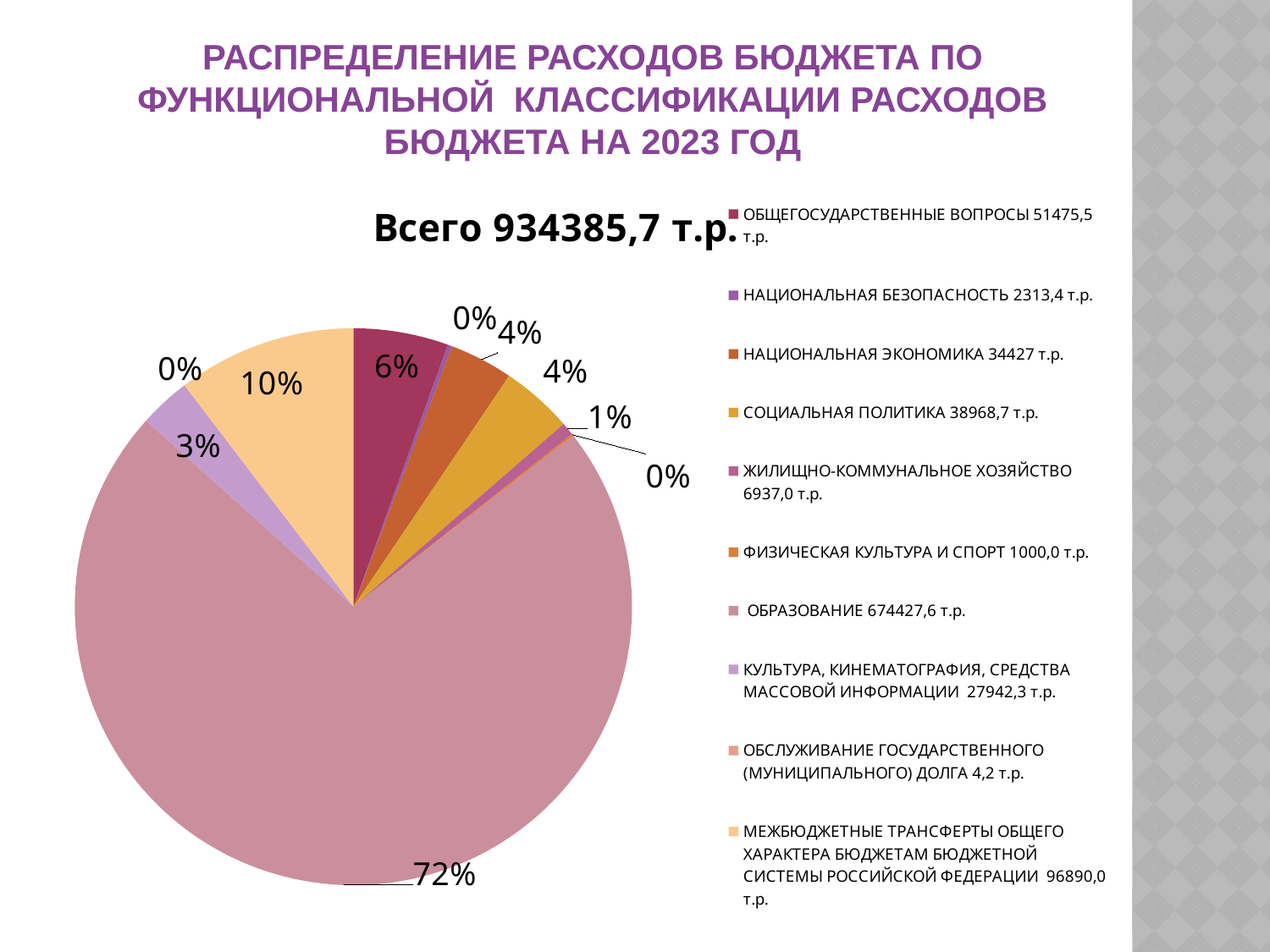
What share of the pie does ОБРАЗОВАНИЕ take? 72% What is the total of all expenditures shown in the chart title? 934385,7 т.р. What share of the pie does ОБЩЕГОСУДАРСТВЕННЫЕ ВОПРОСЫ take? 6% What value does the legend give for ОБРАЗОВАНИЕ? 674427,6 т.р. Which category has the smallest value according to the legend? ОБСЛУЖИВАНИЕ ГОСУДАРСТВЕННОГО (МУНИЦИПАЛЬНОГО) ДОЛГА By how many percentage points does the share of ОБРАЗОВАНИЕ exceed the share of МЕЖБЮДЖЕТНЫЕ ТРАНСФЕРТЫ ОБЩЕГО ХАРАКТЕРА? 62% What value does the legend give for НАЦИОНАЛЬНАЯ ЭКОНОМИКА? 34427 т.р. How many slices (categories) does the pie chart have? 10 Which category has the largest slice of the pie? ОБРАЗОВАНИЕ Which is larger: the value for СОЦИАЛЬНАЯ ПОЛИТИКА or the value for ЖИЛИЩНО-КОММУНАЛЬНОЕ ХОЗЯЙСТВО? СОЦИАЛЬНАЯ ПОЛИТИКА What share of the pie does МЕЖБЮДЖЕТНЫЕ ТРАНСФЕРТЫ ОБЩЕГО ХАРАКТЕРА take? 10% What kind of chart is shown on the slide? pie chart